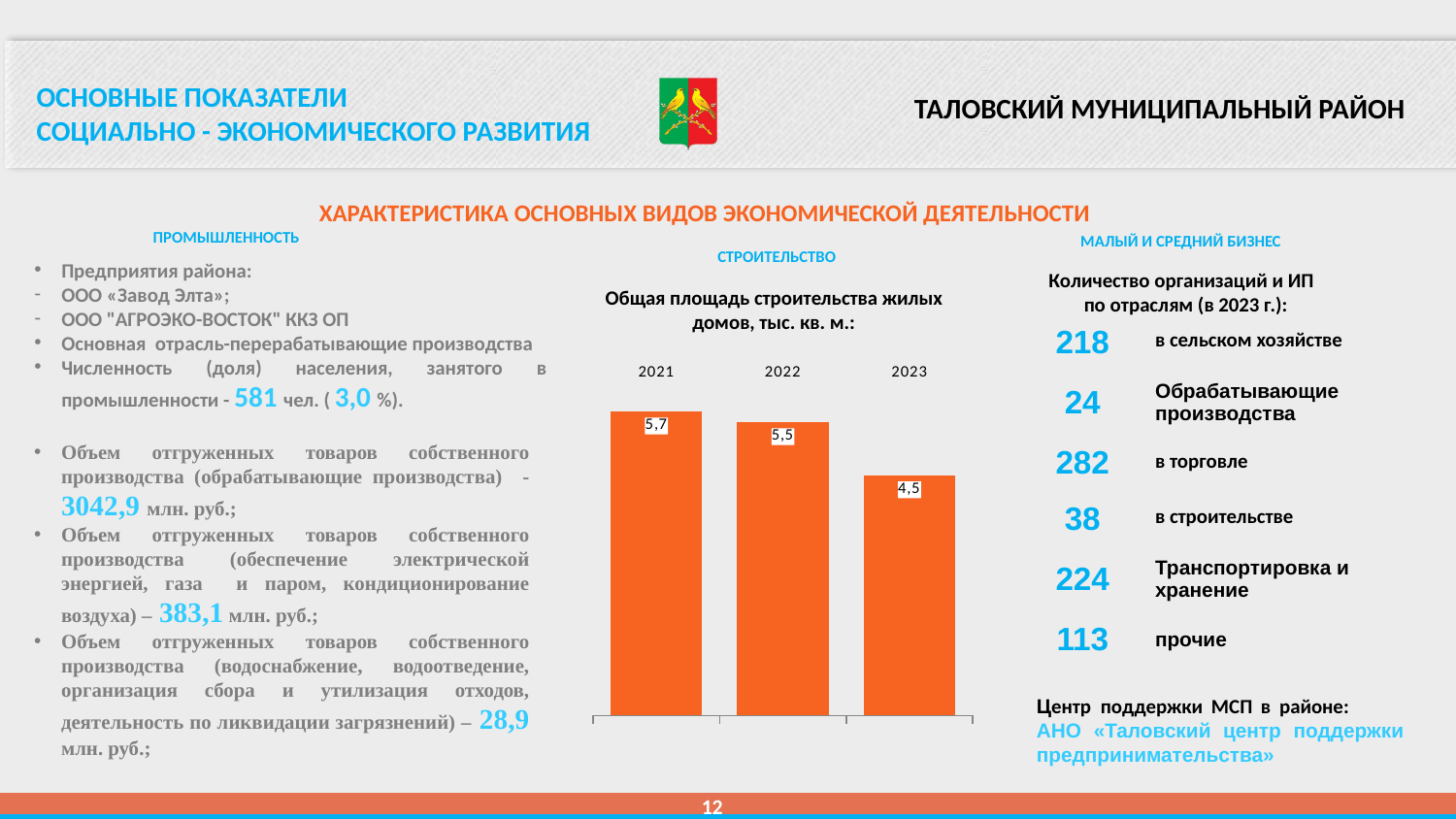
What kind of chart is "Общая площадь строительства жилых домов, тыс. кв. м."? bar chart What is the difference between the 2022 and 2023 values in the chart "Общая площадь строительства жилых домов, тыс. кв. м."? 1,0 How many years (categories) are shown in the chart "Общая площадь строительства жилых домов, тыс. кв. м."? 3 What is the value for 2023 in the chart "Общая площадь строительства жилых домов, тыс. кв. м."? 4,5 Do the values in the chart "Общая площадь строительства жилых домов, тыс. кв. м." rise or fall from 2021 to 2023? fall What is the difference between the 2021 and 2023 values in the chart "Общая площадь строительства жилых домов, тыс. кв. м."? 1,2 What is the value for 2022 in the chart "Общая площадь строительства жилых домов, тыс. кв. м."? 5,5 Which year has the highest value in the chart "Общая площадь строительства жилых домов, тыс. кв. м."? 2021 Which year has the lowest value in the chart "Общая площадь строительства жилых домов, тыс. кв. м."? 2023 What is the value for 2021 in the chart "Общая площадь строительства жилых домов, тыс. кв. м."? 5,7 In the chart "Общая площадь строительства жилых домов, тыс. кв. м.", which is larger: the value for 2022 or the value for 2023? 2022 What colour are the bars in the chart "Общая площадь строительства жилых домов, тыс. кв. м."? orange